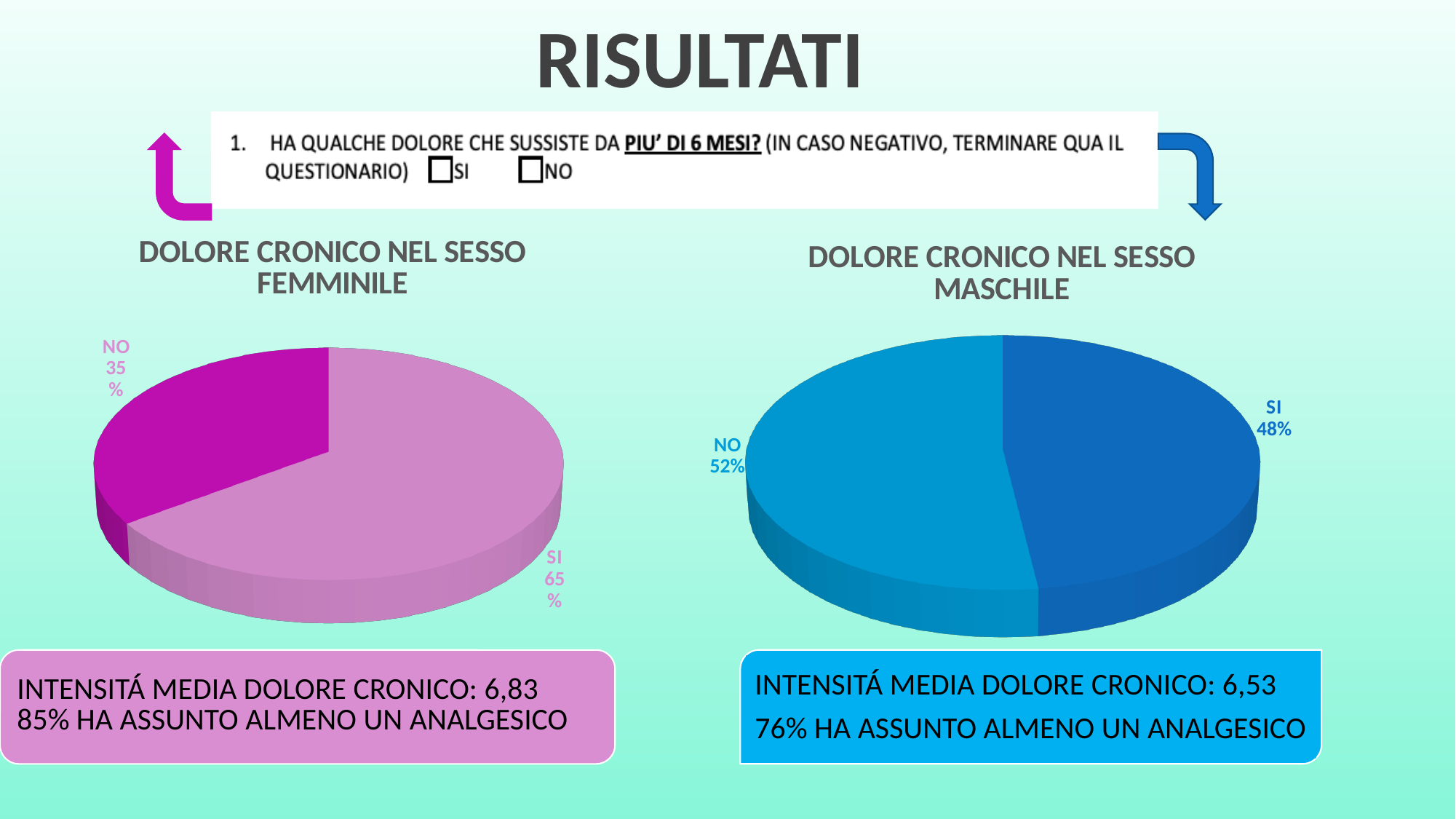
What type of chart is used for 'DOLORE CRONICO NEL SESSO MASCHILE'? Pie chart In the 'DOLORE CRONICO NEL SESSO FEMMINILE' chart, what percentage is shown for SI? 65% How many slices does the 'DOLORE CRONICO NEL SESSO FEMMINILE' pie chart have? 2 How many pie charts are shown on the slide? 2 In the 'DOLORE CRONICO NEL SESSO FEMMINILE' chart, what percentage is shown for NO? 35% In the 'DOLORE CRONICO NEL SESSO MASCHILE' chart, what percentage is shown for SI? 48% In the 'DOLORE CRONICO NEL SESSO MASCHILE' chart, what is the difference between the NO and SI percentages? 4% In the 'DOLORE CRONICO NEL SESSO FEMMINILE' chart, what is the difference between the SI and NO percentages? 30% In the 'DOLORE CRONICO NEL SESSO FEMMINILE' chart, which slice is the largest? SI Is the SI share larger in the 'DOLORE CRONICO NEL SESSO FEMMINILE' chart or in the 'DOLORE CRONICO NEL SESSO MASCHILE' chart? DOLORE CRONICO NEL SESSO FEMMINILE In the 'DOLORE CRONICO NEL SESSO MASCHILE' chart, what percentage is shown for NO? 52% In the 'DOLORE CRONICO NEL SESSO MASCHILE' chart, which slice is the smallest? SI